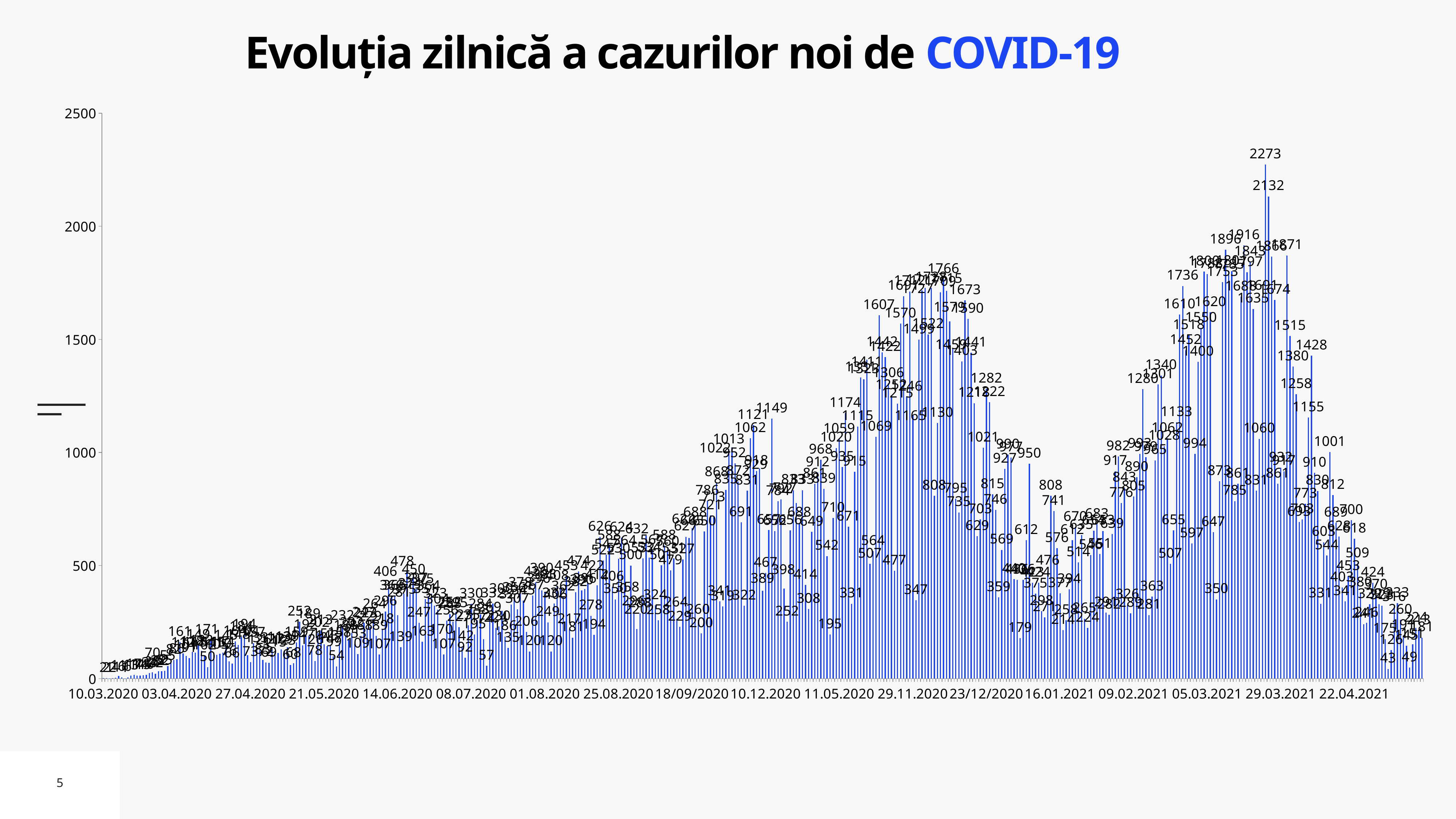
What is the difference between the two highest labelled values, 2273 and 2132? 141 What is the title of the chart? Evoluția zilnică a cazurilor noi de COVID-19 Do the values generally rise or fall between 10.03.2020 and 03.04.2020? rise Is the highest bar on the chart greater or less than 2000? greater What is the first date label on the horizontal axis? 10.03.2020 What is the maximum value shown on the vertical axis? 2500 What is the last date label on the horizontal axis? 22.04.2021 Which is larger, the bar labelled 2273 or the bar labelled 2132? 2273 What is the second-highest value labelled on the chart? 2132 Is the bar labelled 2132 greater or less than 2000? greater What kind of chart is shown on the slide? bar chart What is the highest value labelled on the chart? 2273